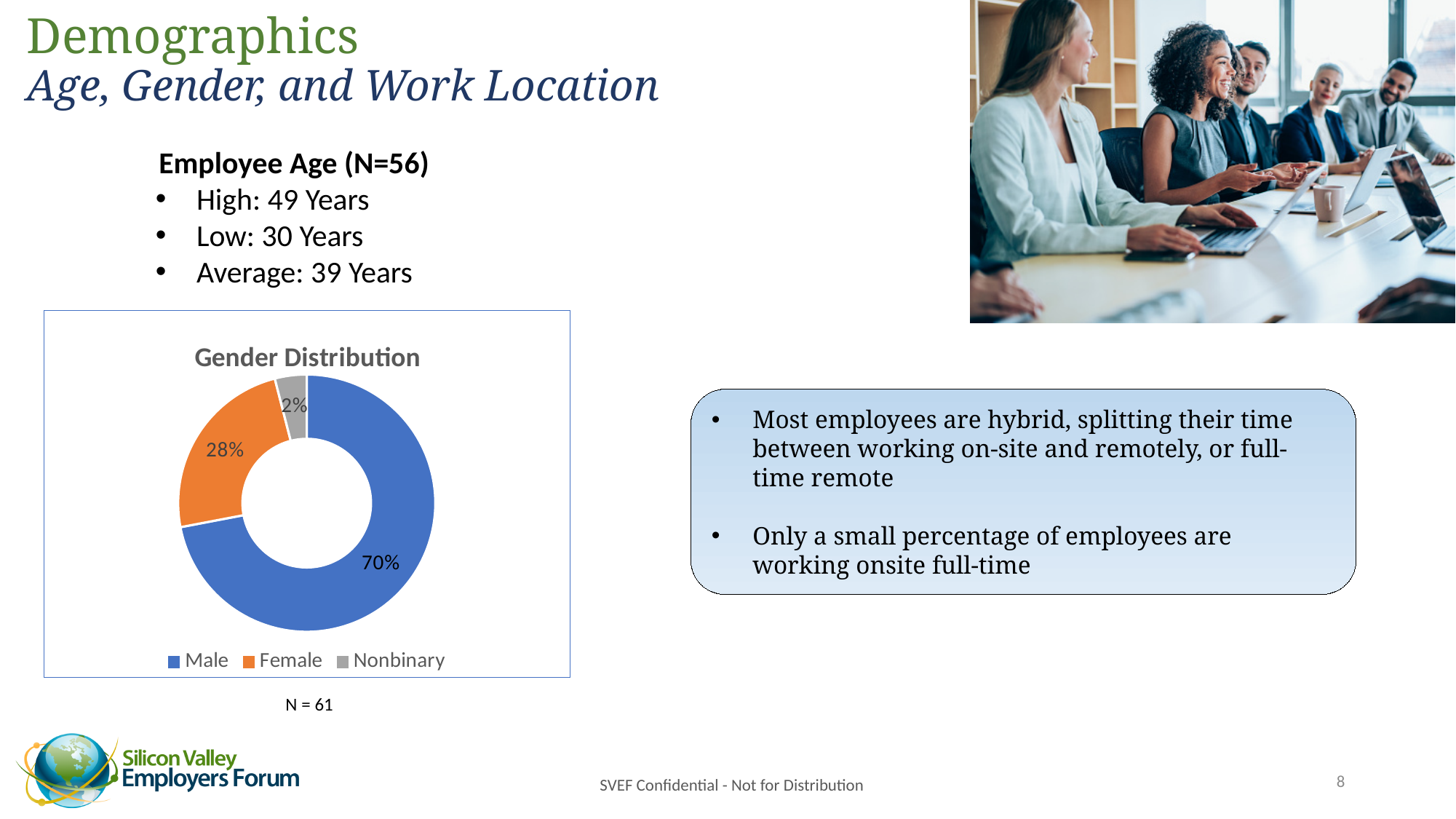
What percentage of the Gender Distribution chart is Male? 70% Which is larger in the Gender Distribution chart, Female or Nonbinary? Female What is the difference in percentage points between Male and Female in the Gender Distribution chart? 42 Which category has the smallest share in the Gender Distribution chart? Nonbinary What percentage of the Gender Distribution chart is Nonbinary? 2% Which category has the largest share in the Gender Distribution chart? Male What is the title of the chart on the slide? Gender Distribution How many categories does the Gender Distribution chart show? 3 What colour represents Female in the Gender Distribution chart? Orange What kind of chart is the Gender Distribution chart? Pie chart (doughnut) What is the sample size (N) noted below the Gender Distribution chart? N = 61 What percentage of the Gender Distribution chart is Female? 28%